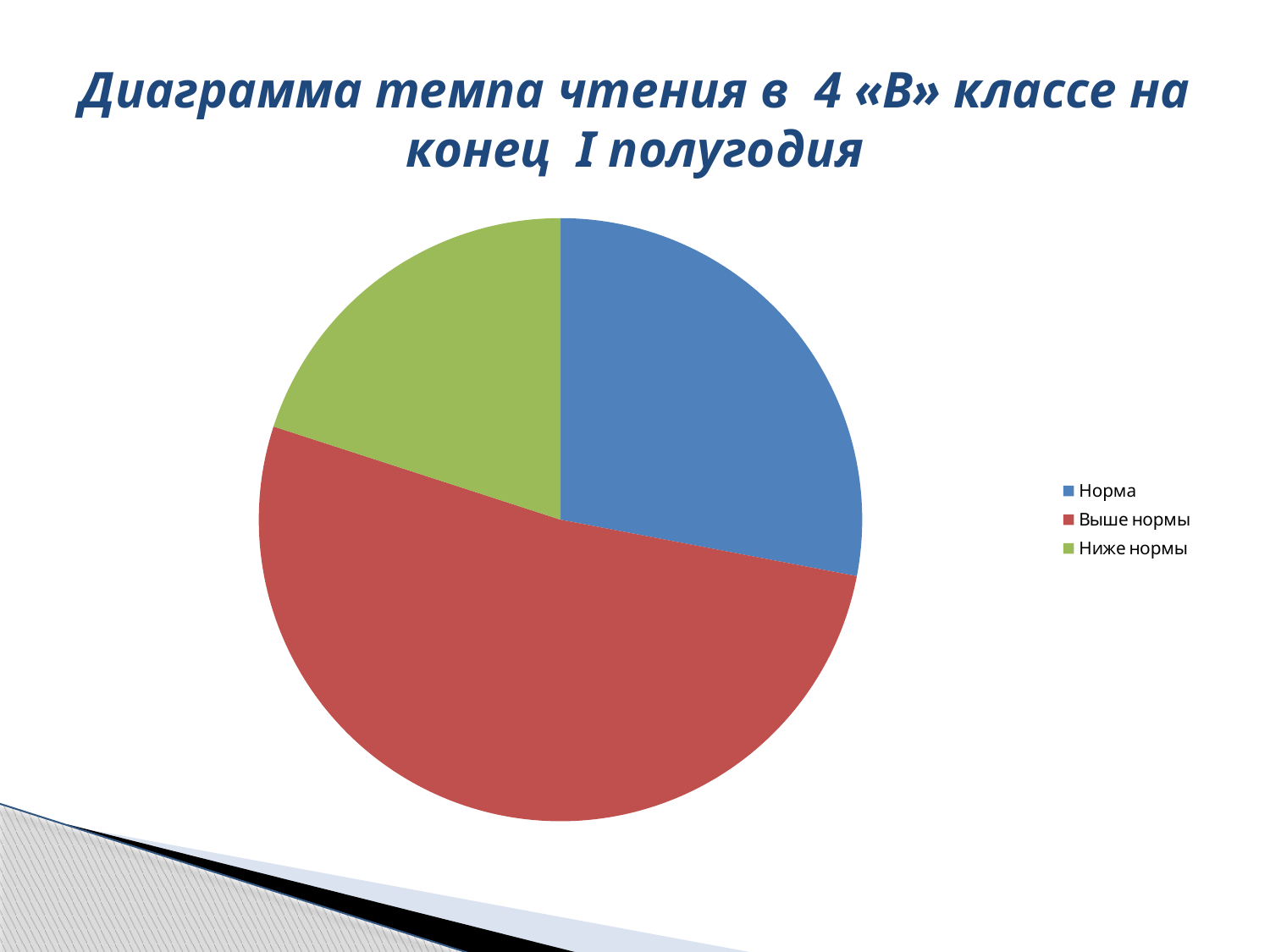
Which category has the smallest slice of the pie? Ниже нормы How many entries does the legend list? 3 What kind of chart is shown on the slide? pie chart Which slice is larger, Норма or Ниже нормы? Норма Which category has the largest slice of the pie? Выше нормы How many slices does the pie chart have? 3 Does the Выше нормы slice take up more or less than half of the pie? more Which category is shown in green? Ниже нормы Which slice is larger, Выше нормы or Норма? Выше нормы What colour is the Норма slice? blue